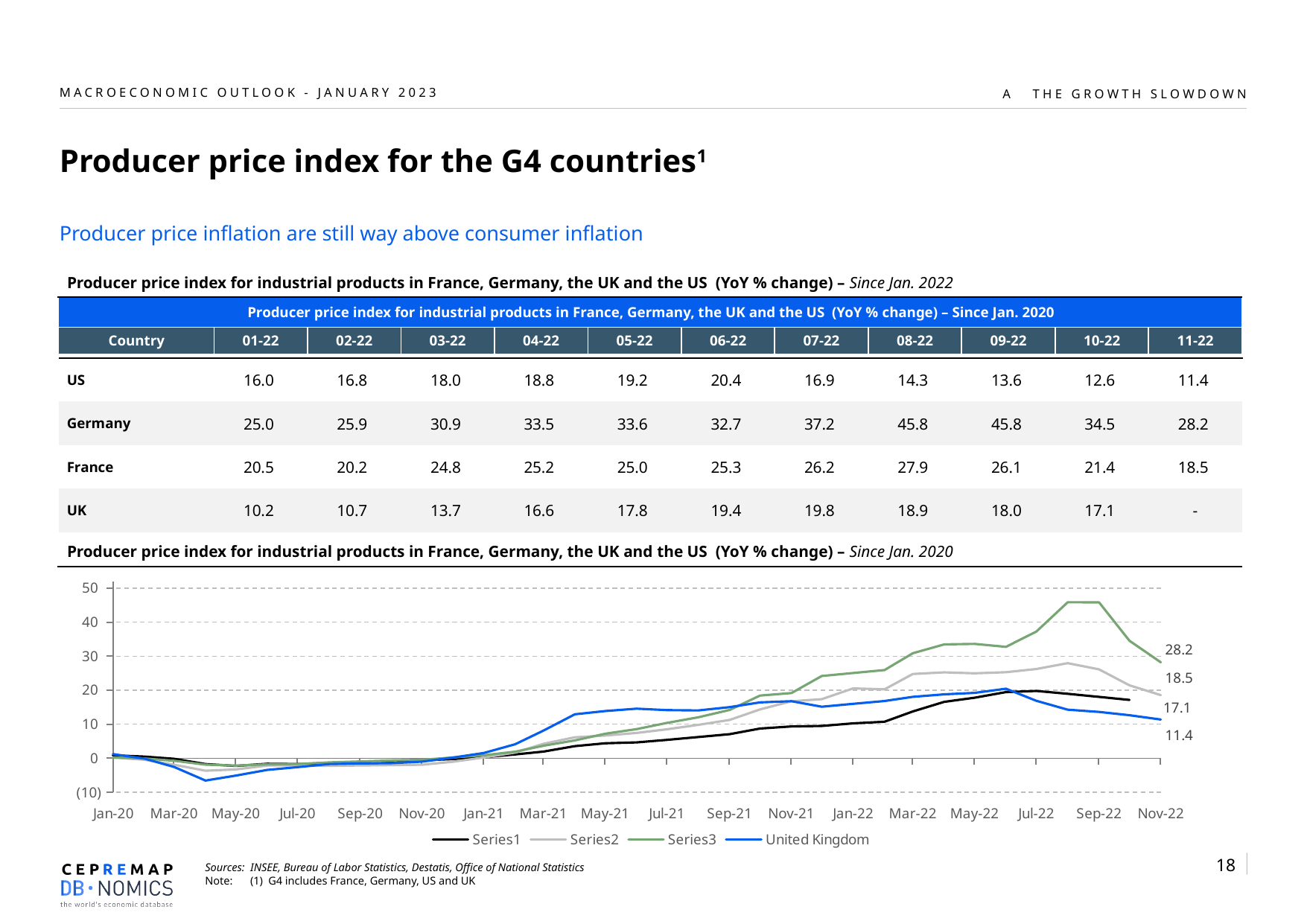
How many series does the chart legend list? 4 Does the Series3 line rise or fall between Sep-22 and Nov-22? fall What are the four series names listed in the chart legend? Series1, Series2, Series3, United Kingdom What is the difference between the end-of-series data labels of Series3 (28.2) and United Kingdom (11.4)? 16.8 What is the data label shown at the end of the grey Series2 line? 18.5 What is the highest value shown on the chart's vertical axis? 50 What is the data label shown at the end of the blue United Kingdom line in Nov-22? 11.4 What type of chart is shown on the slide? line chart What is the data label shown at the end of the green Series3 line in Nov-22? 28.2 Which series has the lowest end-of-series data label? United Kingdom Which series reaches the highest peak value on the chart? Series3 Is the peak value of Series3 in 2022 greater or less than 40? greater